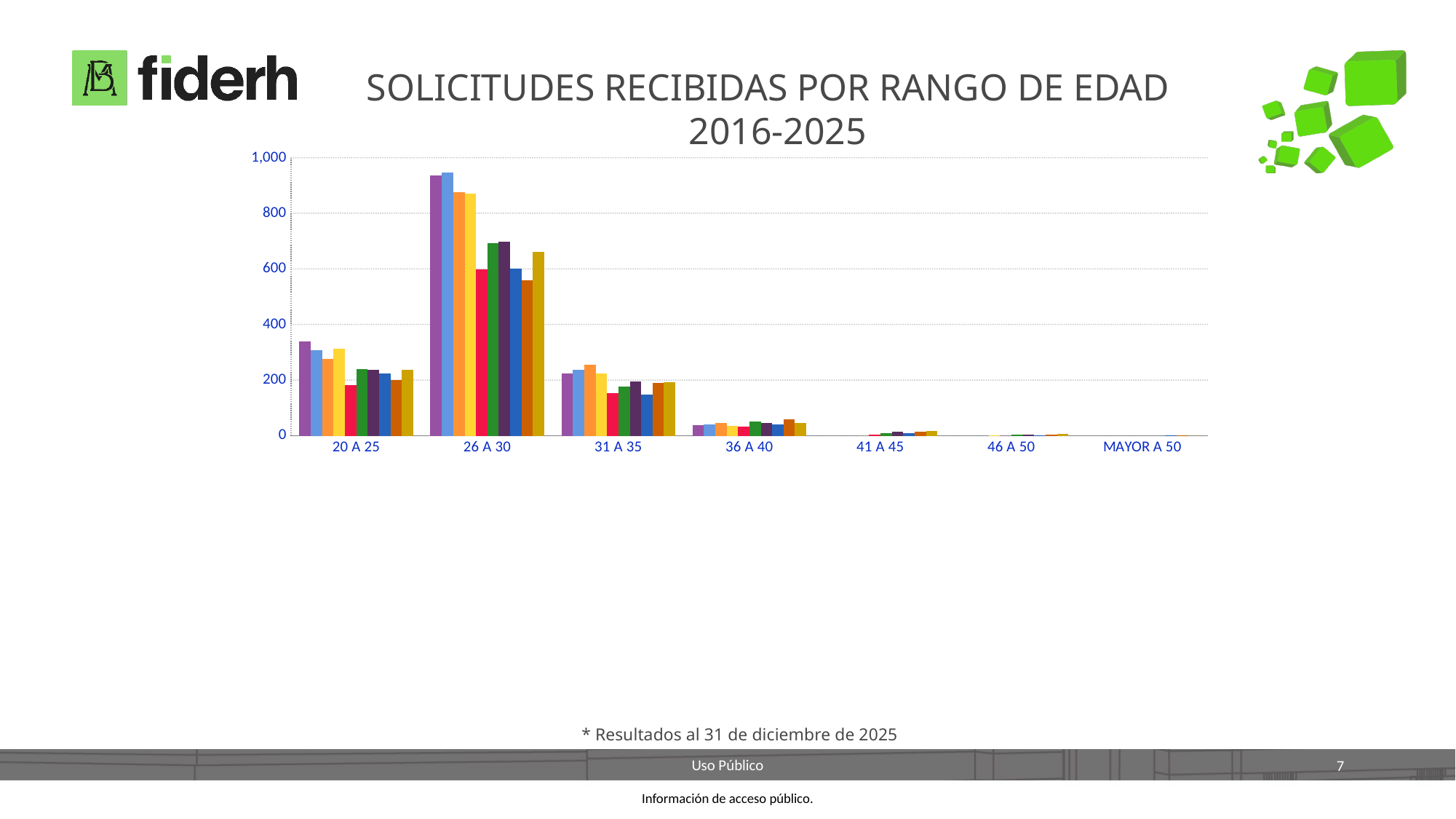
Is the tallest bar in the 20 A 25 group greater or less than 400? less Is the tallest bar in the 31 A 35 group greater or less than 200? greater Which age range has the tallest bars? 26 A 30 What is the title of the chart? SOLICITUDES RECIBIDAS POR RANGO DE EDAD 2016-2025 Do the bar heights rise or fall moving from 26 A 30 to MAYOR A 50 along the x axis? fall What kind of chart is shown on the slide? bar chart Which group has taller bars overall, 20 A 25 or 31 A 35? 20 A 25 Is the tallest bar in the 26 A 30 group greater or less than 800? greater How many age-range categories are shown on the x axis? 7 What is the highest value shown on the vertical axis? 1,000